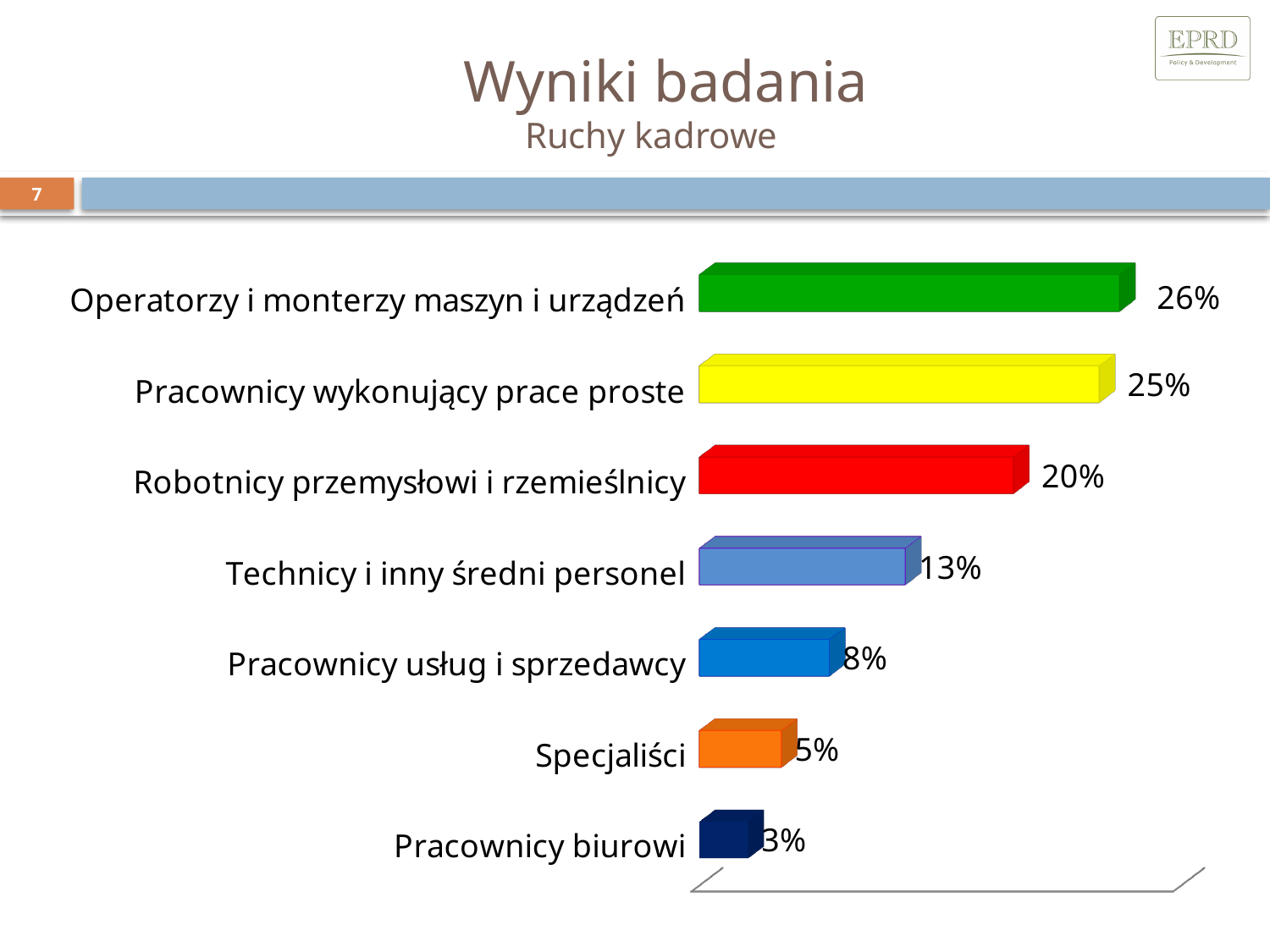
What is the value for Specjaliści? 5% What is the difference between the values for Operatorzy i monterzy maszyn i urządzeń and Pracownicy wykonujący prace proste? 1% What is the difference between the values for Robotnicy przemysłowi i rzemieślnicy and Pracownicy usług i sprzedawcy? 12% Which is larger: the value for Technicy i inny średni personel or the value for Pracownicy usług i sprzedawcy? Technicy i inny średni personel Which category has the highest value? Operatorzy i monterzy maszyn i urządzeń What kind of chart is shown on the slide? Bar chart What colour is the bar for Robotnicy przemysłowi i rzemieślnicy? Red Which category has the lowest value? Pracownicy biurowi What is the value for Technicy i inny średni personel? 13% What is the value for Pracownicy biurowi? 3% How many categories are shown in the chart? 7 What is the value for Operatorzy i monterzy maszyn i urządzeń? 26%